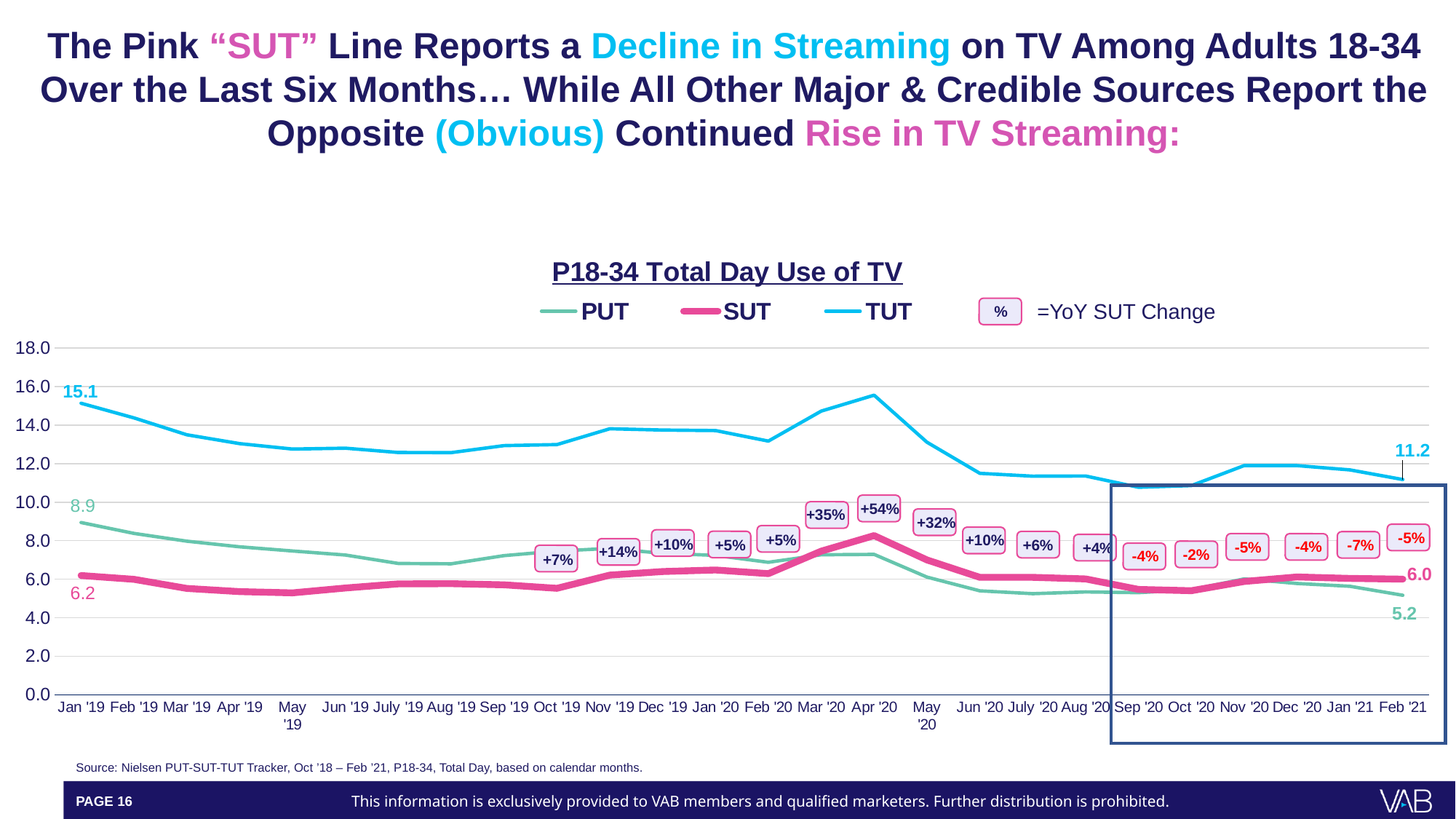
Which series has the highest value in Feb '21? TUT Does the PUT line rise or fall from Jan '19 to Feb '21? fall What is the TUT value for Feb '21? 11.2 What is the SUT value for Feb '21? 6.0 Is the TUT value for Apr '20 greater or less than 14.0? greater What is the YoY SUT change label shown for Apr '20? +54% What type of chart is shown on the slide? line chart What is the PUT value for Jan '19? 8.9 What is the difference between the TUT value in Jan '19 and the TUT value in Feb '21? 3.9 What is the title of the chart? P18-34 Total Day Use of TV What is the TUT value for Jan '19? 15.1 How many series does the chart legend list? 3